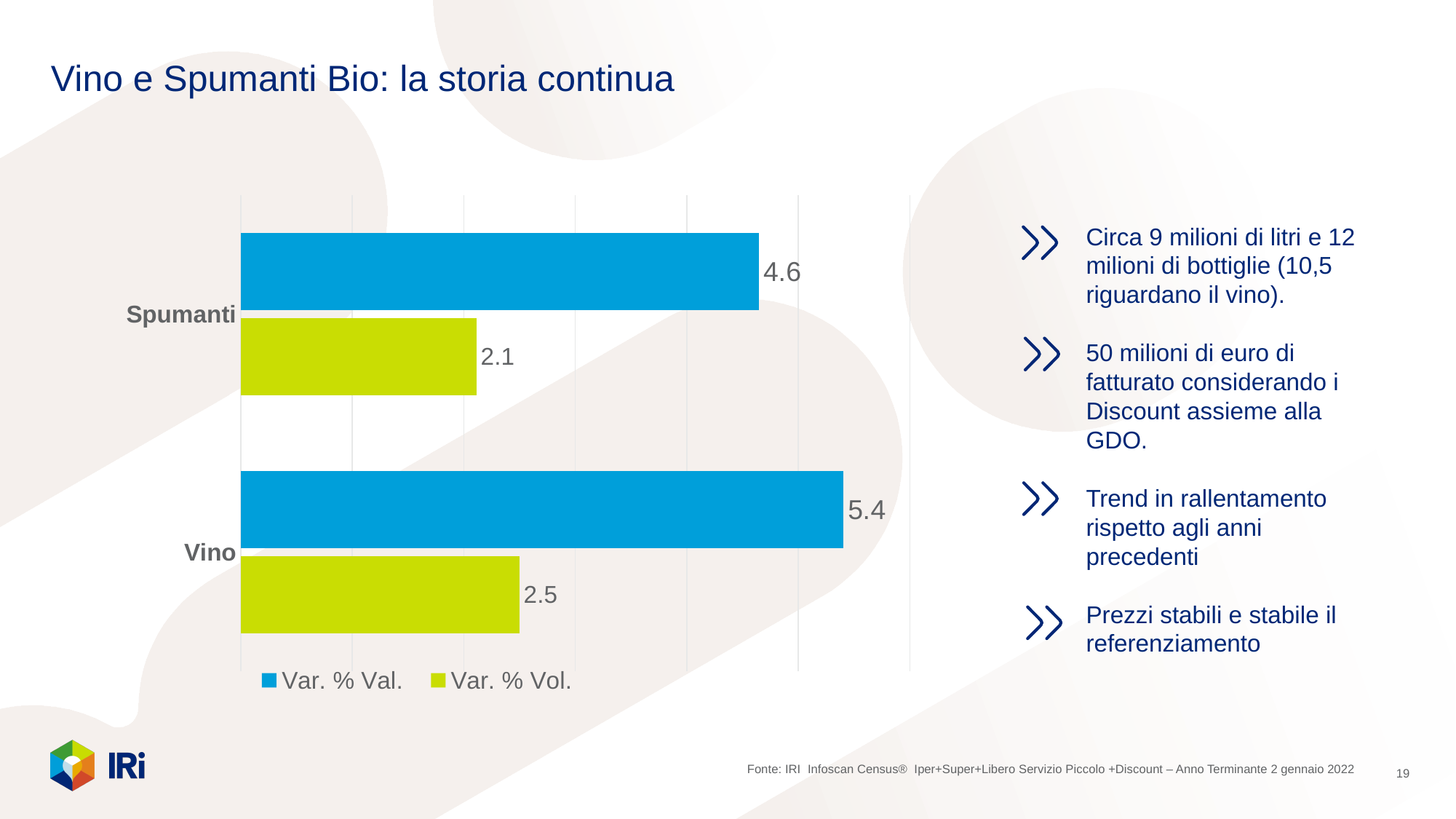
What is the Var. % Val. value for Spumanti? 4.6 Which category has the highest Var. % Val. value? Vino How many series does the legend list? 2 Which is larger for Spumanti: Var. % Val. or Var. % Vol.? Var. % Val. What kind of chart is shown on the slide? Bar chart What is the Var. % Val. value for Vino? 5.4 Which category has the lowest Var. % Vol. value? Spumanti What is the difference between the Var. % Val. values for Vino and Spumanti? 0.8 What is the Var. % Vol. value for Vino? 2.5 What is the difference between the Var. % Val. and Var. % Vol. values for Vino? 2.9 How many categories are shown on the chart? 2 What is the Var. % Vol. value for Spumanti? 2.1